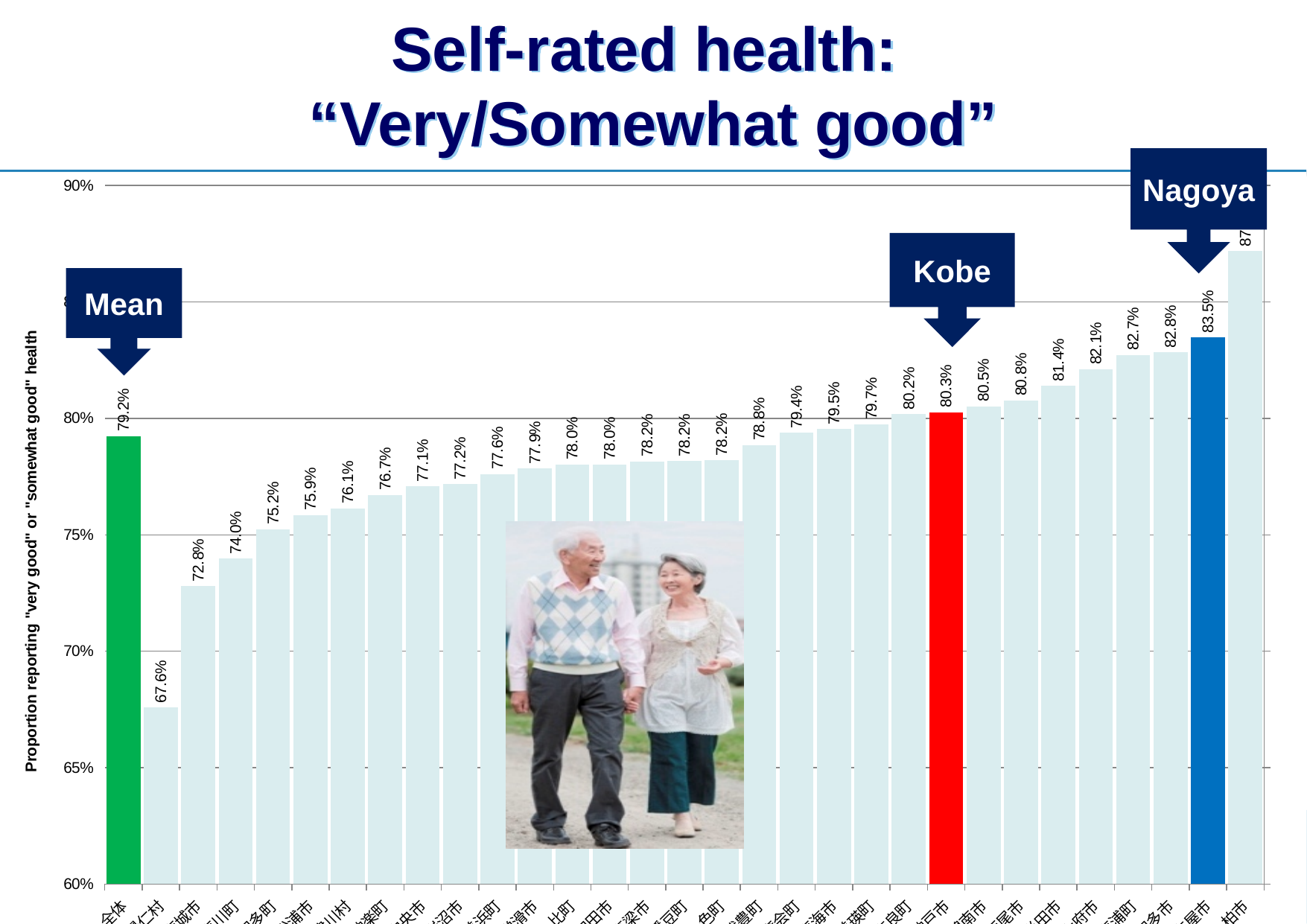
How many percentage points higher is Kobe than the Mean? 1.1 percentage points Do the bar values generally rise or fall from left to right after the Mean bar? Rise What is the value of the bar marked "Nagoya"? 83.5% Is the value for Nagoya greater or less than 80%? greater Is the value for the Mean greater or less than 80%? less What is the value of the bar marked "Mean"? 79.2% What colour is the bar marked "Kobe"? Red What kind of chart is shown on the slide? Bar chart Which is larger, the value for Kobe or the value for Nagoya? Nagoya What is the lowest value labelled on the chart? 67.6% How many percentage points higher is Nagoya than Kobe? 3.2 percentage points What is the value of the bar marked "Kobe"? 80.3%